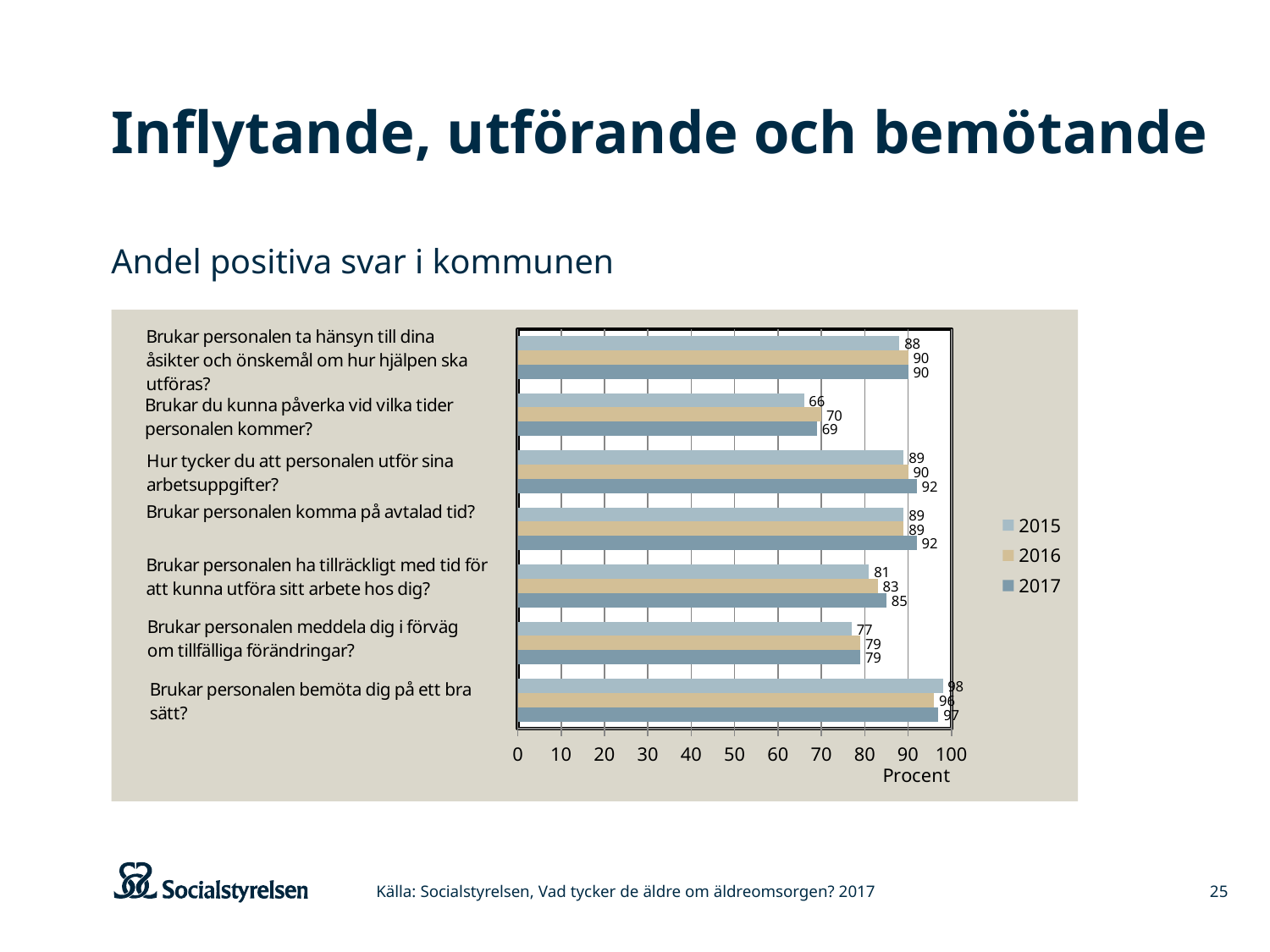
What is the difference between the 2017 and 2015 values for "Brukar personalen ha tillräckligt med tid för att kunna utföra sitt arbete hos dig?"? 4 Which question has the highest 2017 value? Brukar personalen bemöta dig på ett bra sätt? What is the 2016 value for "Brukar personalen ha tillräckligt med tid för att kunna utföra sitt arbete hos dig?"? 83 What kind of chart is shown on the slide? bar chart How many series does the legend list? 3 For "Brukar personalen bemöta dig på ett bra sätt?", which year has the larger value, 2015 or 2016? 2015 Which question has the lowest 2015 value? Brukar du kunna påverka vid vilka tider personalen kommer? What is the 2015 value for "Brukar personalen bemöta dig på ett bra sätt?"? 98 Is the 2016 value for "Brukar personalen meddela dig i förväg om tillfälliga förändringar?" greater or less than 70? greater What is the label on the horizontal axis of the chart? Procent What is the 2017 value for "Brukar du kunna påverka vid vilka tider personalen kommer?"? 69 How many questions (categories) are shown in the chart? 7